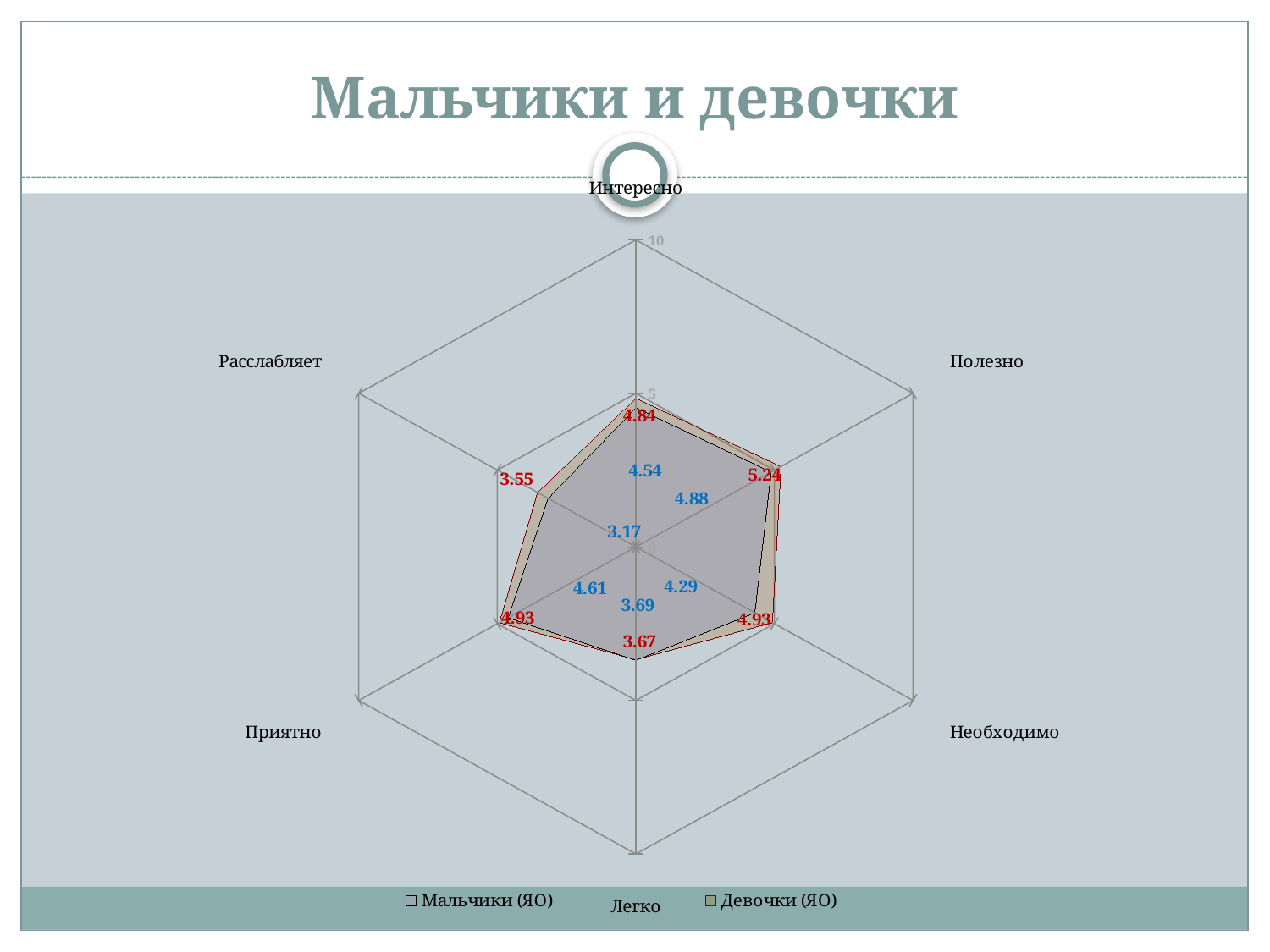
Is the value for Полезно in the Мальчики (ЯО) series greater or less than 5? less What is the title of the slide containing the chart? Мальчики и девочки How many series does the legend list? 2 What is the value for Расслабляет in the Мальчики (ЯО) series? 3.17 Which category has the highest value in the Девочки (ЯО) series? Полезно Which category has the lowest value in the Мальчики (ЯО) series? Расслабляет For Интересно, which series has the larger value, Мальчики (ЯО) or Девочки (ЯО)? Девочки (ЯО) How many categories (axes) does the radar chart have? 6 What is the difference between the Девочки (ЯО) and Мальчики (ЯО) values for Необходимо? 0.64 What is the value for Легко in the Девочки (ЯО) series? 3.67 What kind of chart is shown on the slide? radar chart What is the value for Полезно in the Девочки (ЯО) series? 5.24